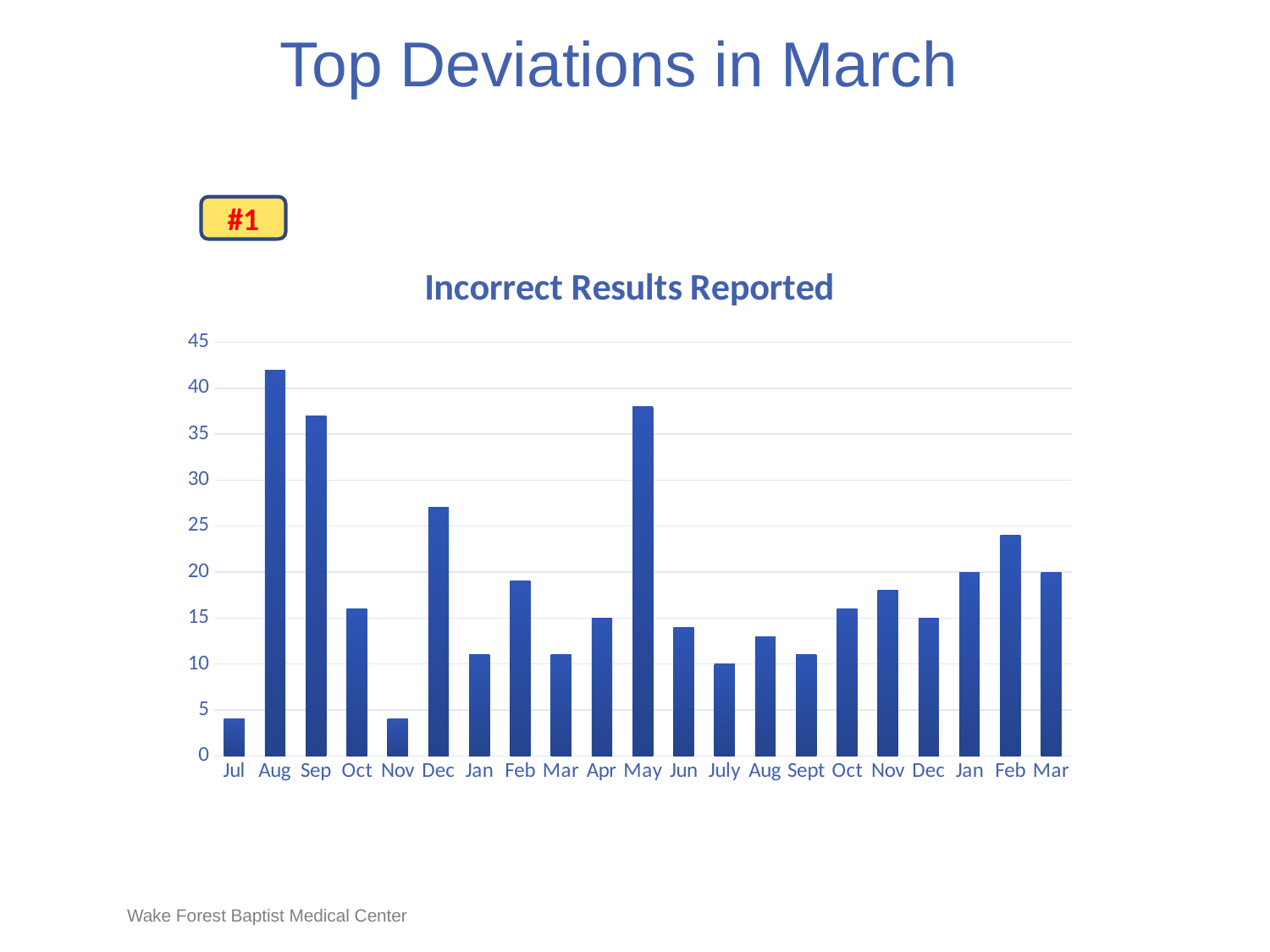
Which month has the highest bar in the chart? Aug (the first Aug bar) What is the value for July? 10 How many bars are plotted in the chart? 21 What is the title of the chart? Incorrect Results Reported Which is larger, the first Dec bar or the second Feb bar? Dec Is the value for the first Dec bar greater or less than 25? greater What kind of chart is shown on the slide? bar chart Is the value for May greater or less than 35? greater Is the value for the first Jul bar greater or less than 5? less Which is larger, the first Aug bar or the Sep bar? Aug